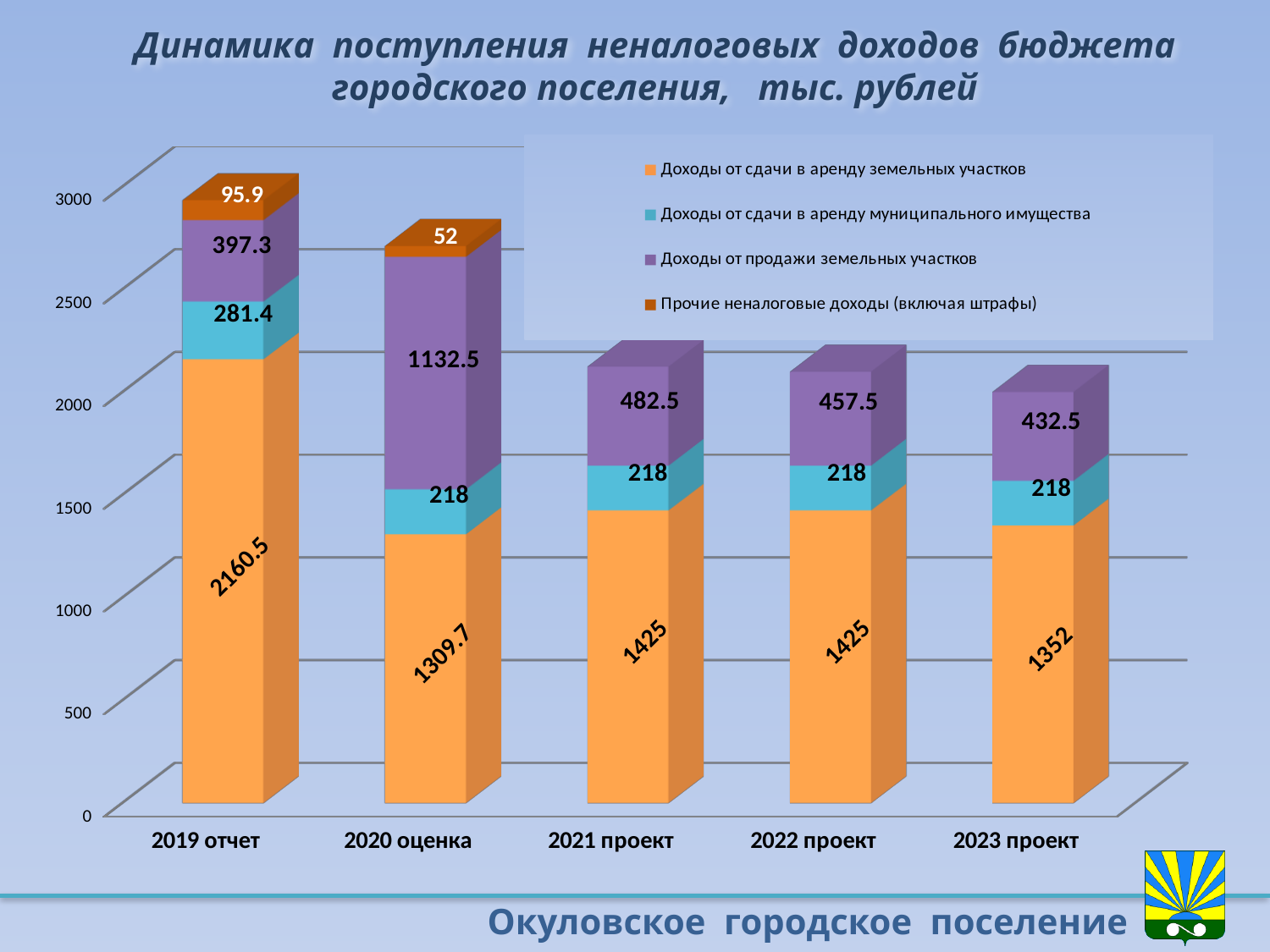
Which category has the highest value for 'Доходы от сдачи в аренду земельных участков'? 2019 отчет How many series does the legend list? 4 What is the value of 'Доходы от сдачи в аренду земельных участков' for 2019 отчет? 2160.5 What kind of chart is shown on the slide? stacked bar chart What is the value of 'Доходы от сдачи в аренду муниципального имущества' for 2023 проект? 218 What is the difference between 'Доходы от продажи земельных участков' in 2021 проект and 2023 проект? 50 Which category has the lowest value for 'Доходы от продажи земельных участков'? 2019 отчет What is the value of 'Доходы от продажи земельных участков' for 2020 оценка? 1132.5 How many categories are shown on the x axis? 5 What is the value of 'Прочие неналоговые доходы (включая штрафы)' for 2019 отчет? 95.9 Which is larger: 'Доходы от сдачи в аренду земельных участков' in 2020 оценка or in 2023 проект? 2023 проект What is the total of the stacked bar for 2019 отчет? 2935.1